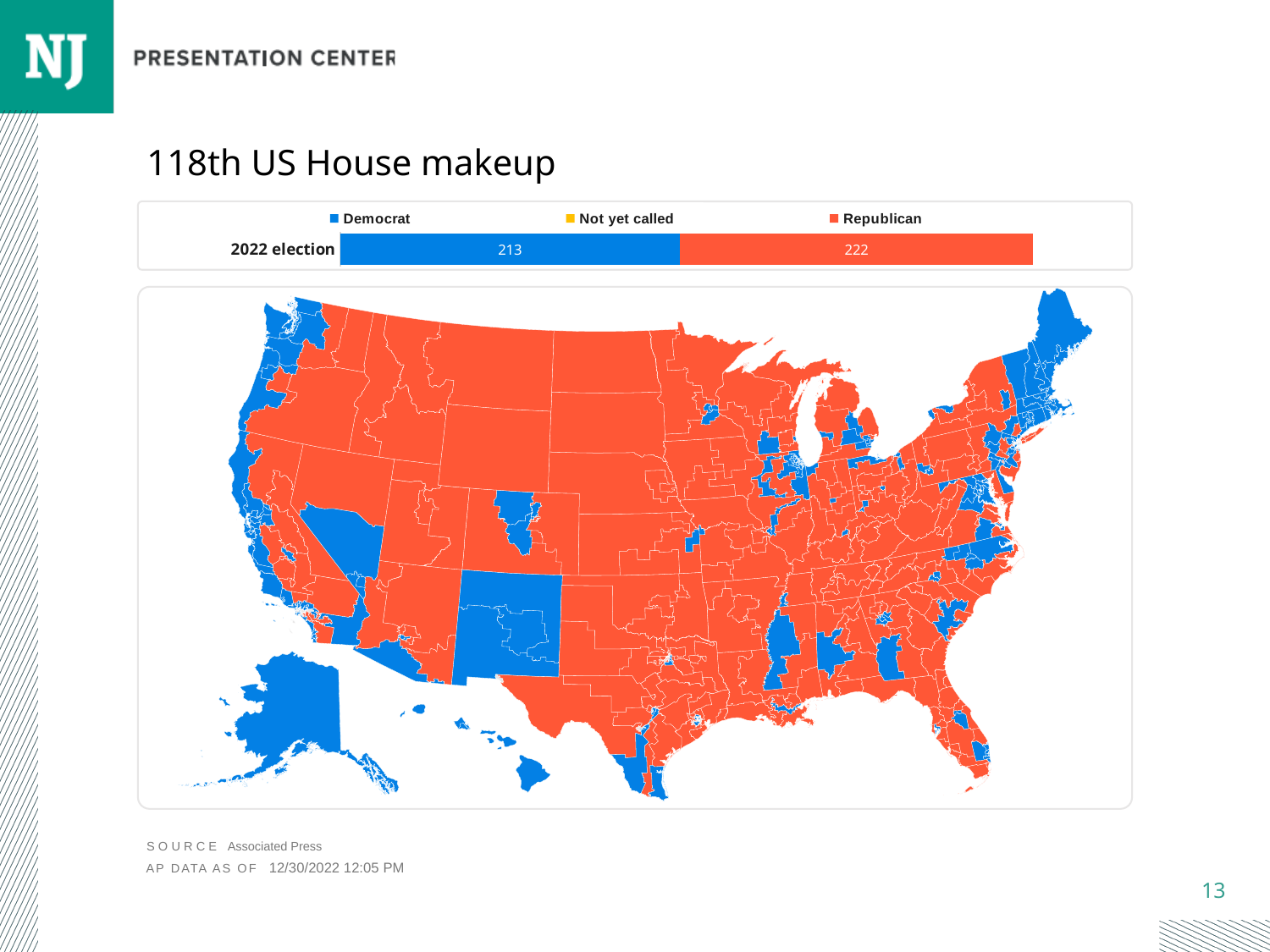
In the stacked bar chart, what is the total of the 2022 election bar (Democrat plus Republican)? 435 How many series does the legend of the stacked bar chart list? 3 How many categories (rows) does the stacked bar chart show? 1 In the stacked bar chart, is the Democrat value greater or less than 220? less In the stacked bar chart, how many seats are shown for Republican in the 2022 election? 222 In the stacked bar chart, what is the difference between the Republican and Democrat seat counts? 9 What is the label of the single category in the stacked bar chart? 2022 election What kind of chart is shown above the map? Stacked bar chart In the stacked bar chart, which series has the smallest visible segment? Democrat In the stacked bar chart, which party has the larger number of seats, Democrat or Republican? Republican What is the title of the chart on the slide? 118th US House makeup In the stacked bar chart, how many seats are shown for Democrat in the 2022 election? 213